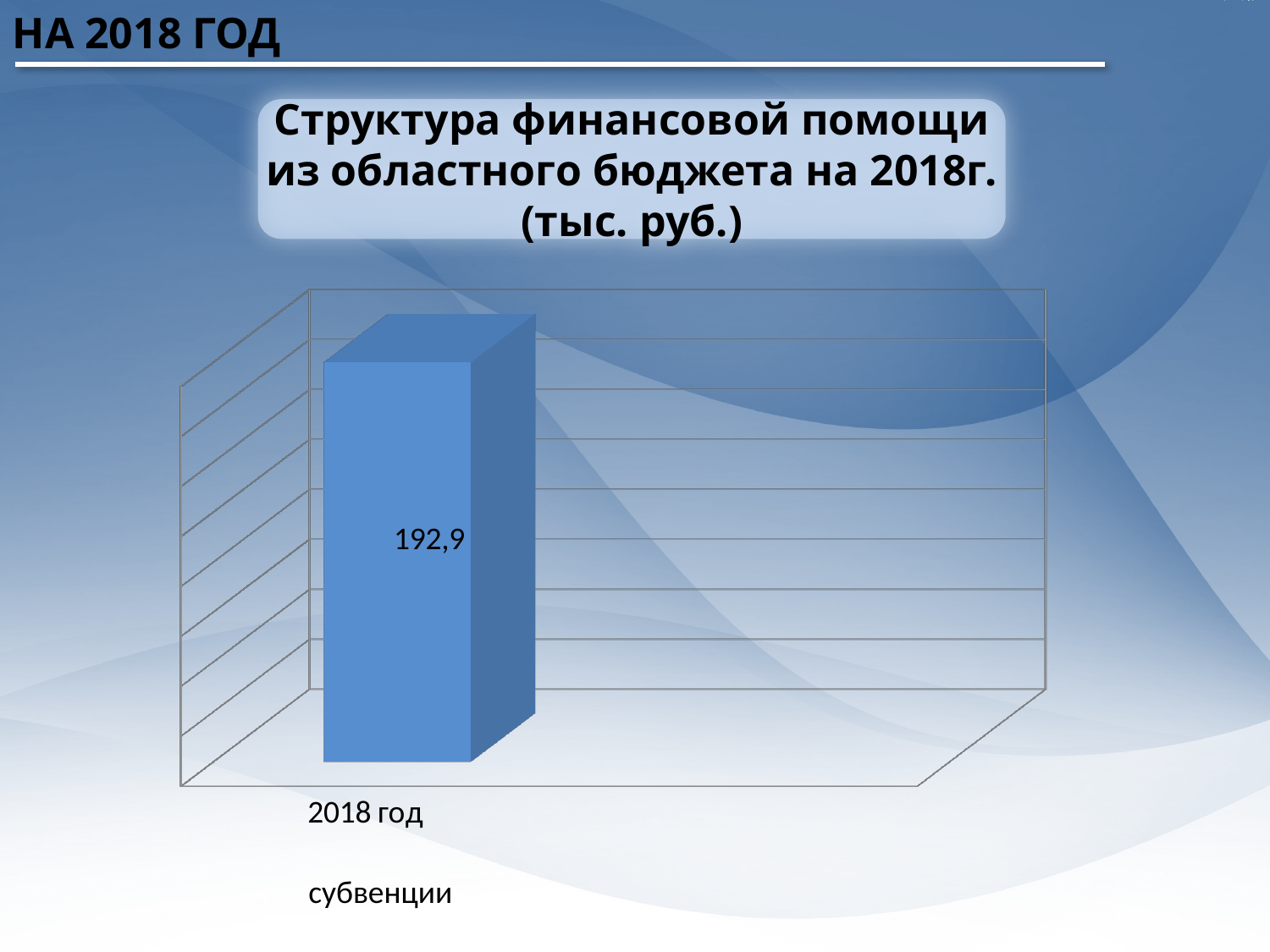
What kind of chart is shown on the slide? Bar chart What is the value of субвенции for 2018 год? 192,9 What unit of measurement is stated in the chart title? тыс. руб. What category label appears under the bar? 2018 год How many bars are plotted in the chart? 1 How many series does the legend list? 1 What is the name of the series shown in the legend? субвенции How many categories are shown on the x axis? 1 What is the value shown on the bar for 2018 год? 192,9